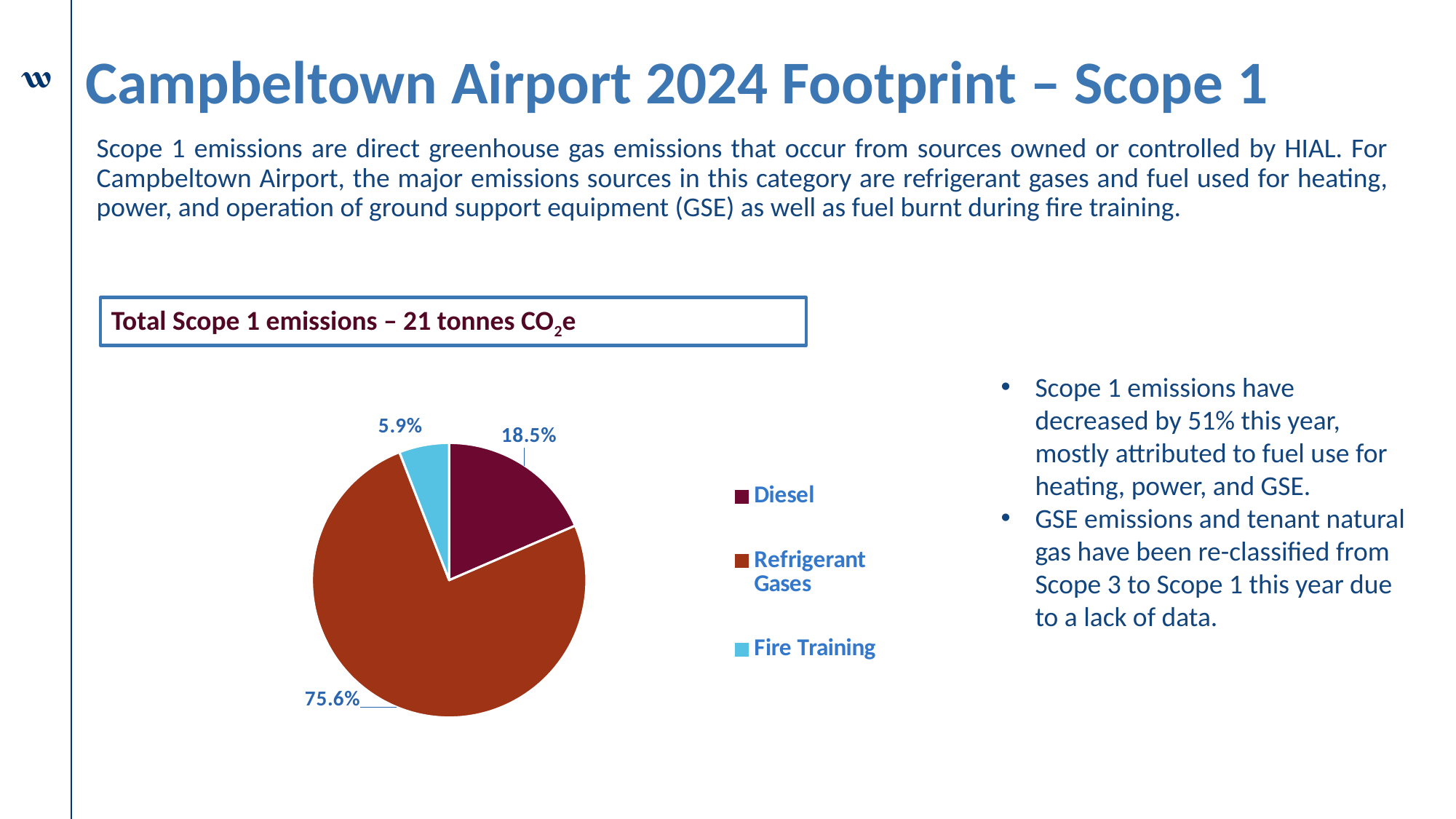
What is the difference in percentage points between the Diesel share and the Fire Training share? 12.6 How many categories does the pie chart show? 3 What is the difference in percentage points between the Refrigerant Gases share and the Diesel share? 57.1 Which category has the smallest slice of the pie? Fire Training Which category has the largest slice of the pie? Refrigerant Gases Which is larger, the Diesel slice or the Fire Training slice? Diesel What share of Scope 1 emissions comes from Refrigerant Gases? 75.6% What total Scope 1 emissions figure is stated in the box above the chart? 21 tonnes CO2e What colour is the Fire Training slice in the pie chart? Light blue What kind of chart is shown on the slide? Pie chart What share of Scope 1 emissions comes from Fire Training? 5.9% What share of Scope 1 emissions comes from Diesel? 18.5%